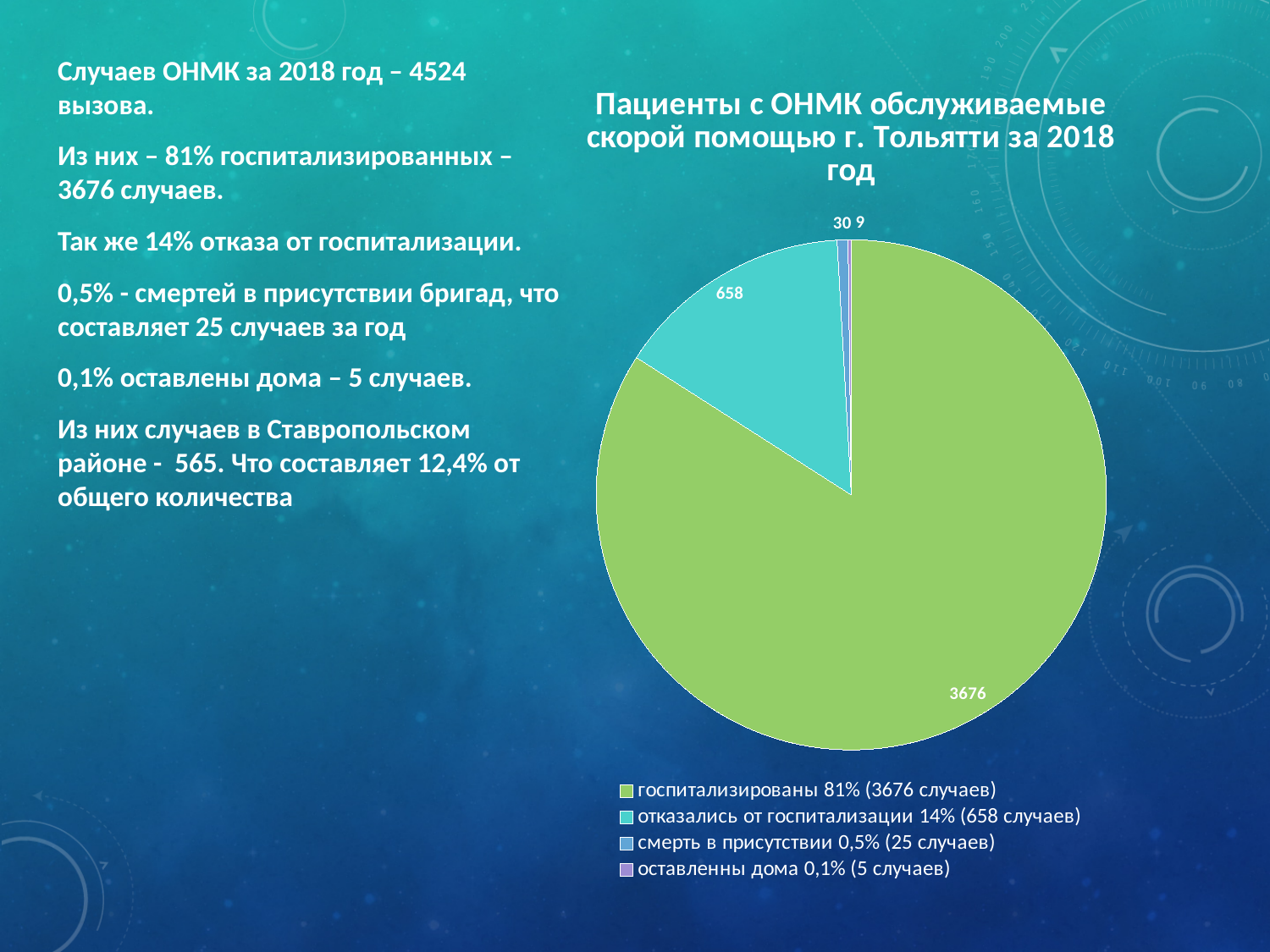
Which is larger: the slice for госпитализированы or the slice for отказались от госпитализации? госпитализированы Which category has the largest slice of the pie? госпитализированы What is the data label on the slice for госпитализированы? 3676 According to the legend, what share of the pie is отказались от госпитализации? 14% What colour is the largest slice of the pie? green How many categories does the legend list? 4 What is the title of the chart? Пациенты с ОНМК обслуживаемые скорой помощью г. Тольятти за 2018 год What is the data label on the slice for отказались от госпитализации? 658 According to the legend, what share of the pie is госпитализированы? 81% Which category has the smallest slice of the pie? оставленны дома What kind of chart is shown on the slide? pie chart What is the difference between the data labels for госпитализированы and отказались от госпитализации? 3018